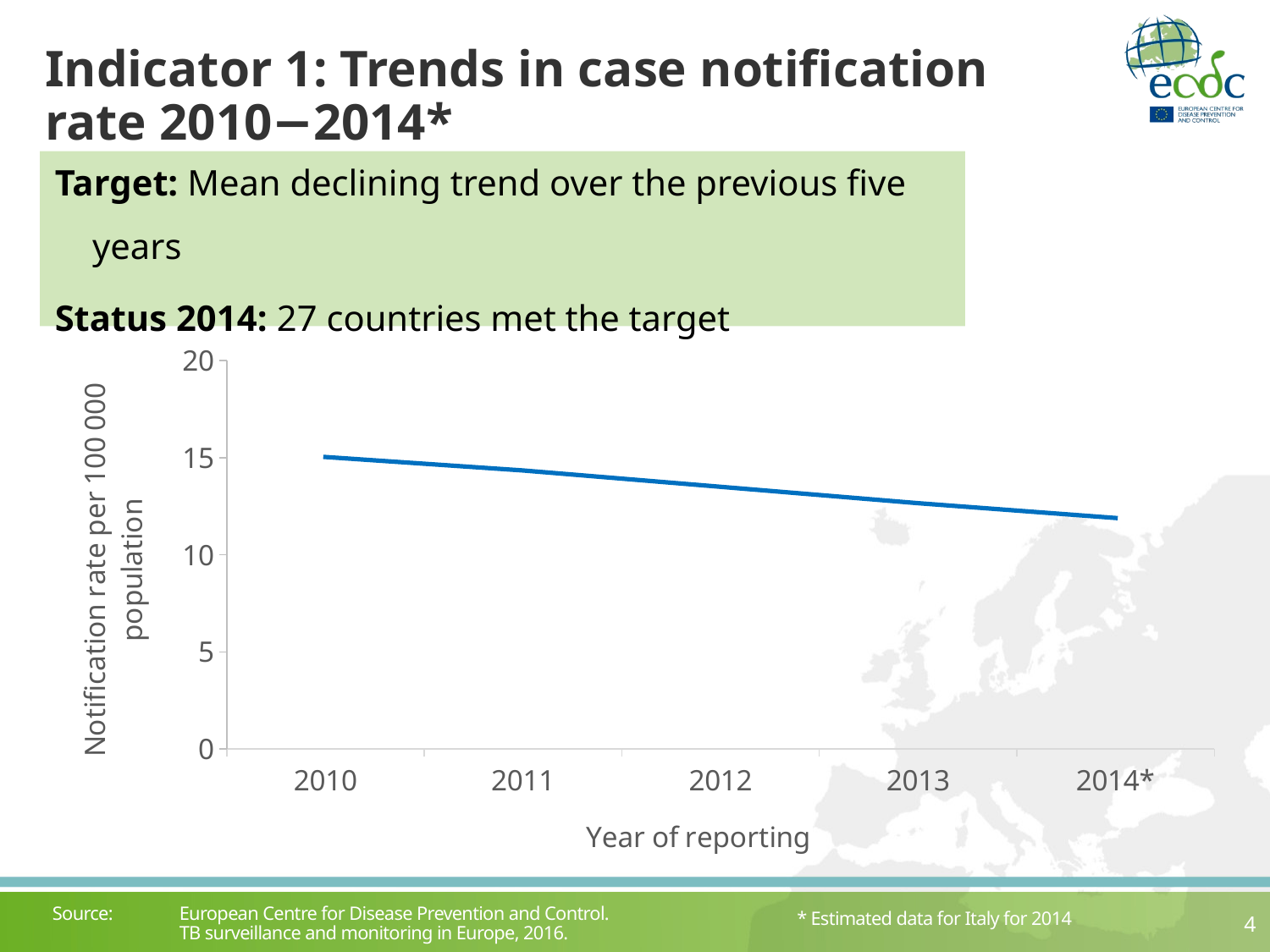
Is the notification rate for 2014* greater or less than 10? greater Does the notification rate rise or fall from 2010 to 2014*? Fall Is the notification rate for 2012 greater or less than 10? greater What kind of chart is shown on the slide? Line chart Which year has the lowest notification rate? 2014* Is the notification rate for 2010 greater or less than 10? greater Which year has the larger notification rate, 2010 or 2014*? 2010 How many years of reporting are shown on the x axis? 5 What is the label of the x axis? Year of reporting Which year has the highest notification rate? 2010 What is the label of the y axis? Notification rate per 100 000 population